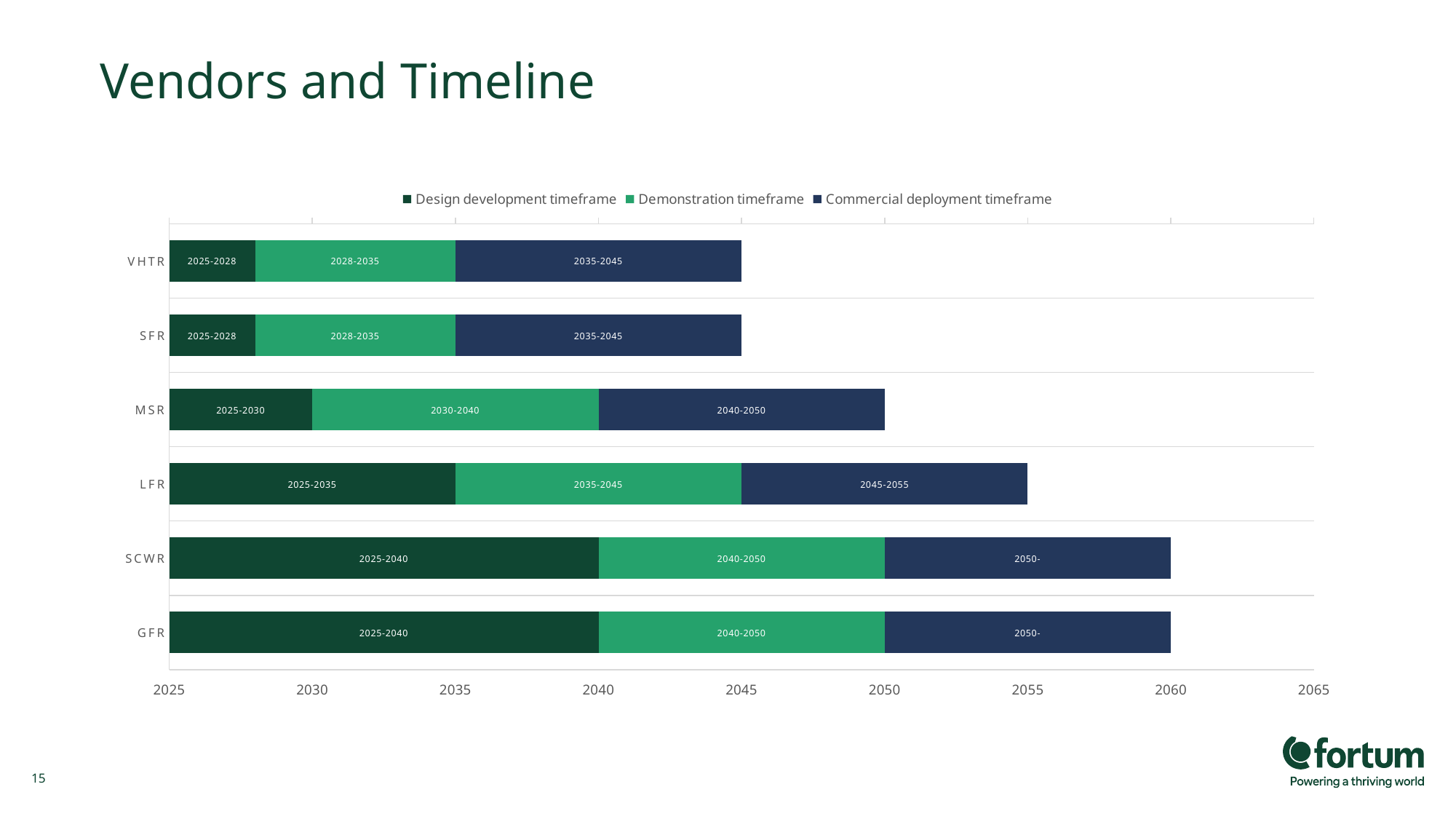
Is the end of the LFR bar greater or less than 2050 on the horizontal axis? greater How many series does the chart legend list? 3 What is the commercial deployment timeframe shown for SCWR? 2050- What is the design development timeframe shown for MSR? 2025-2030 What kind of chart is shown on the slide? Bar chart What is the demonstration timeframe shown for LFR? 2035-2045 Which reactor type has a commercial deployment timeframe of 2045-2055? LFR What is the design development timeframe shown for GFR? 2025-2040 Which ends later, the commercial deployment timeframe for MSR or for LFR? LFR What is the commercial deployment timeframe shown for VHTR? 2035-2045 How many reactor types are listed on the vertical axis of the chart? 6 What is the title of the slide containing the chart? Vendors and Timeline